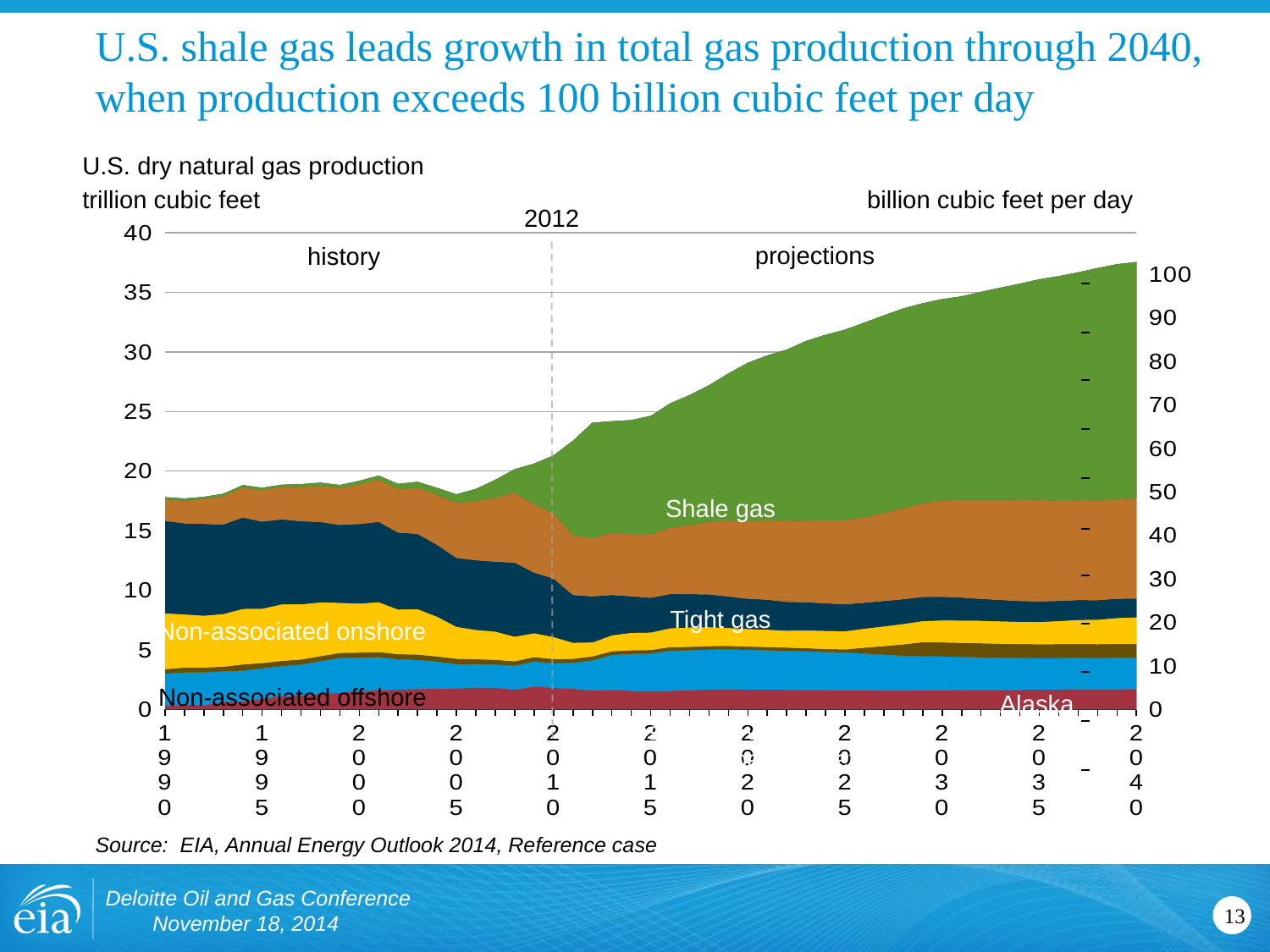
Which year does the dashed vertical line separating history from projections mark? 2012 Is total U.S. dry natural gas production in 2012 greater or less than 25 trillion cubic feet? less What kind of chart is shown on the slide? Stacked area chart What unit is shown on the left vertical axis of the chart? trillion cubic feet Is total U.S. dry natural gas production in 1990 greater or less than 20 trillion cubic feet? less How many year labels are shown along the x axis? 11 In 2040, which is larger: shale gas production or tight gas production? Shale gas Is total U.S. dry natural gas production in 2030 greater or less than 30 trillion cubic feet? greater Does total U.S. dry natural gas production rise or fall between 2012 and 2040? rise Which labeled source contributes the most to U.S. dry natural gas production in 2040? Shale gas What is the title of the chart? U.S. dry natural gas production